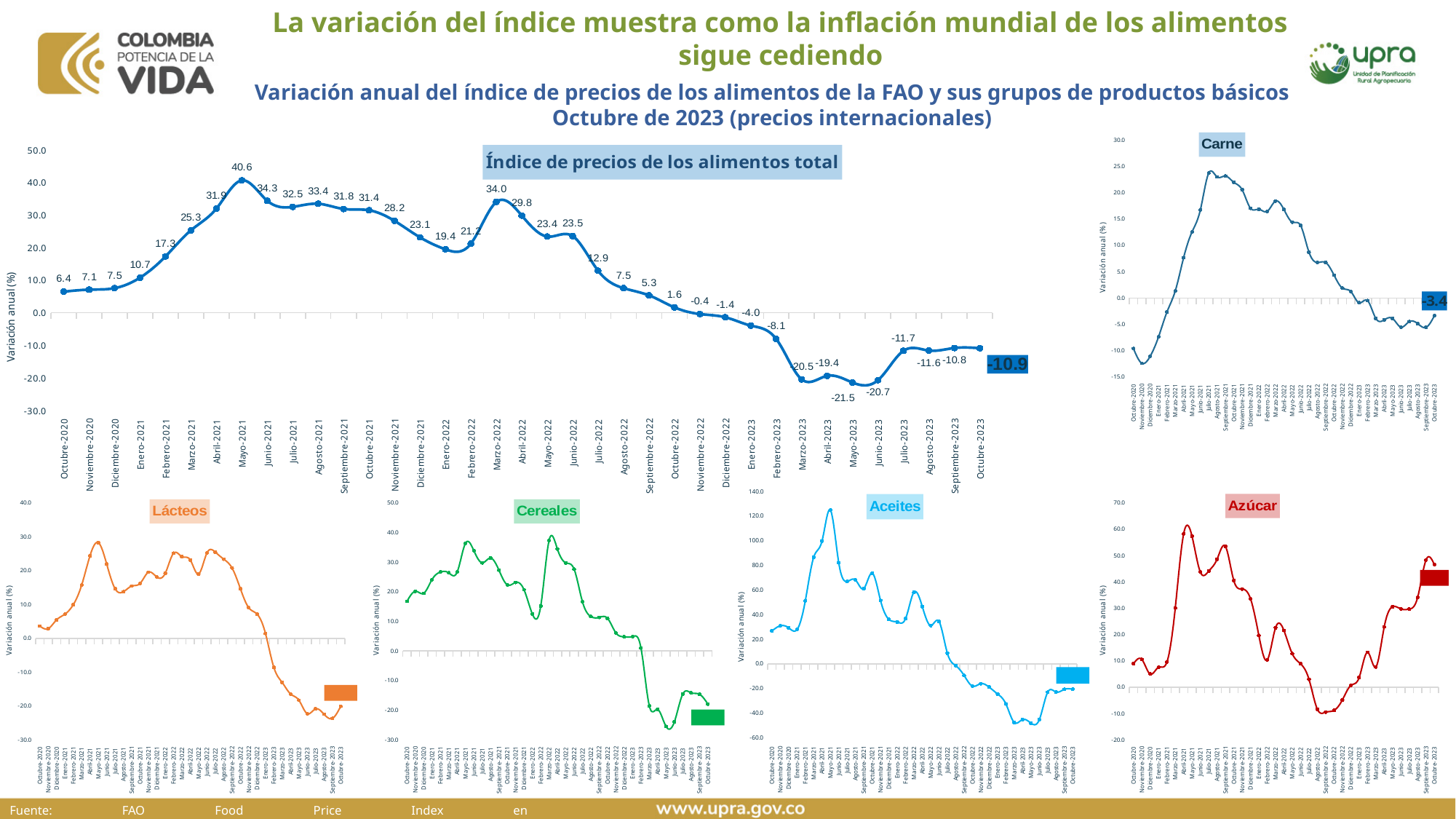
On the 'Índice de precios de los alimentos total' chart, which is larger, the value for Abril-2022 or the value for Julio-2022? Abril-2022 On the 'Índice de precios de los alimentos total' chart, what is the difference between the values for Mayo-2021 and Junio-2021? 6.3 On the 'Índice de precios de los alimentos total' chart, what is the value for Marzo-2022? 34.0 On the 'Índice de precios de los alimentos total' chart, which month has the highest value? Mayo-2021 On the 'Índice de precios de los alimentos total' chart, what is the value for Octubre-2023? -10.9 On the 'Carne' chart, what is the value for Octubre-2023? -3.4 What kind of chart is the 'Índice de precios de los alimentos total' chart? line chart How many smaller product-group charts (besides the total index chart) are shown on the slide? 5 On the 'Índice de precios de los alimentos total' chart, is the value for Febrero-2021 greater or less than 20.0? less On the 'Índice de precios de los alimentos total' chart, which month has the lowest value? Mayo-2023 On the 'Índice de precios de los alimentos total' chart, what is the value for Mayo-2021? 40.6 On the 'Carne' chart, is the peak value greater or less than 20.0? greater